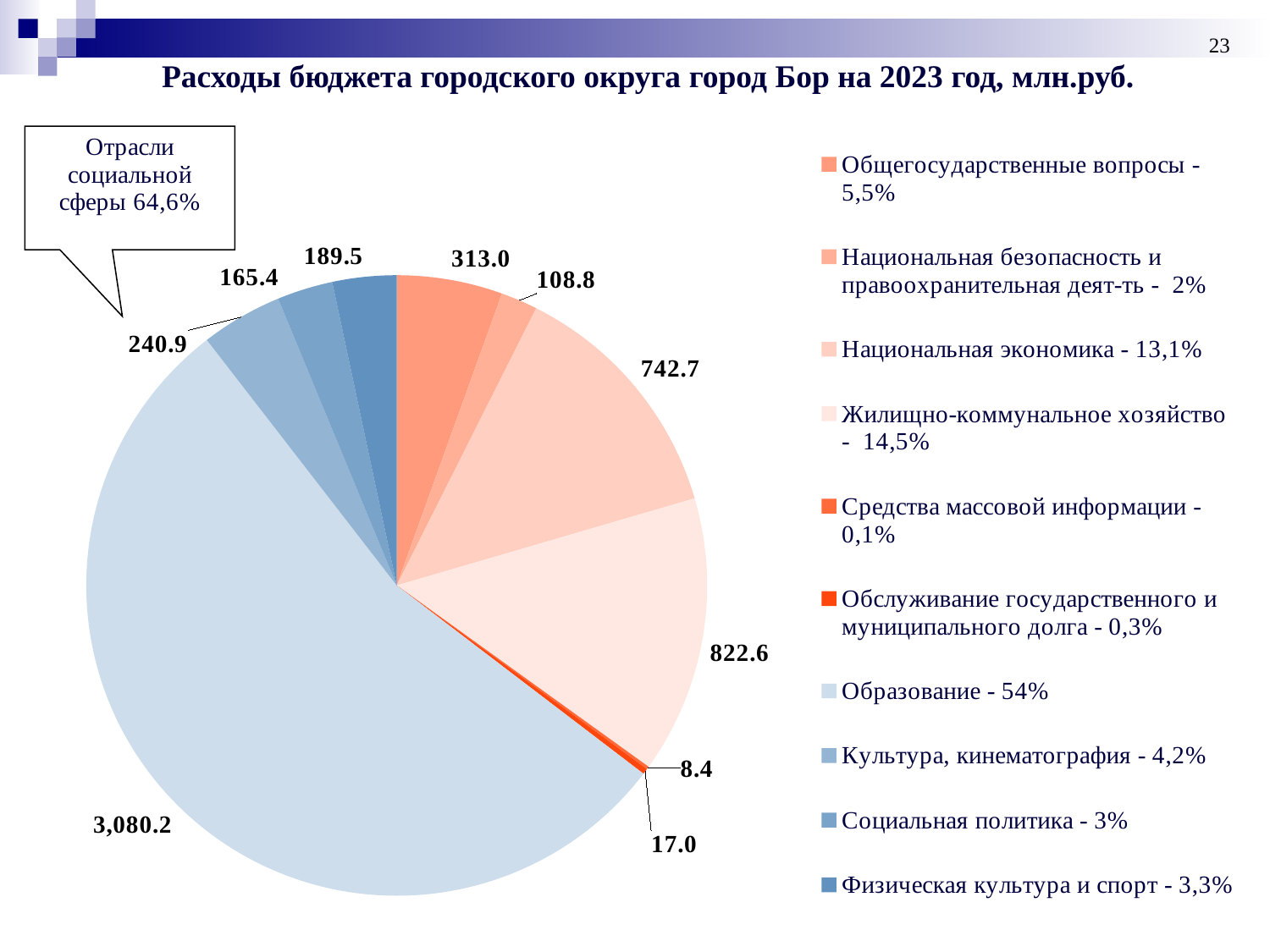
What is the difference between the values for Жилищно-коммунальное хозяйство and Национальная экономика? 79.9 What is the value for Образование? 3,080.2 What is the title of the chart? Расходы бюджета городского округа город Бор на 2023 год, млн.руб. What share of the pie does Образование represent, according to the legend? 54% How many categories does the legend list? 10 What kind of chart is shown on the slide? pie chart Which category has the smallest slice of the pie? Средства массовой информации What is the value for Культура, кинематография? 240.9 Which category has the largest slice of the pie? Образование What is the value for Жилищно-коммунальное хозяйство? 822.6 Which is larger, the value for Физическая культура и спорт or the value for Социальная политика? Физическая культура и спорт What is the value for Национальная экономика? 742.7